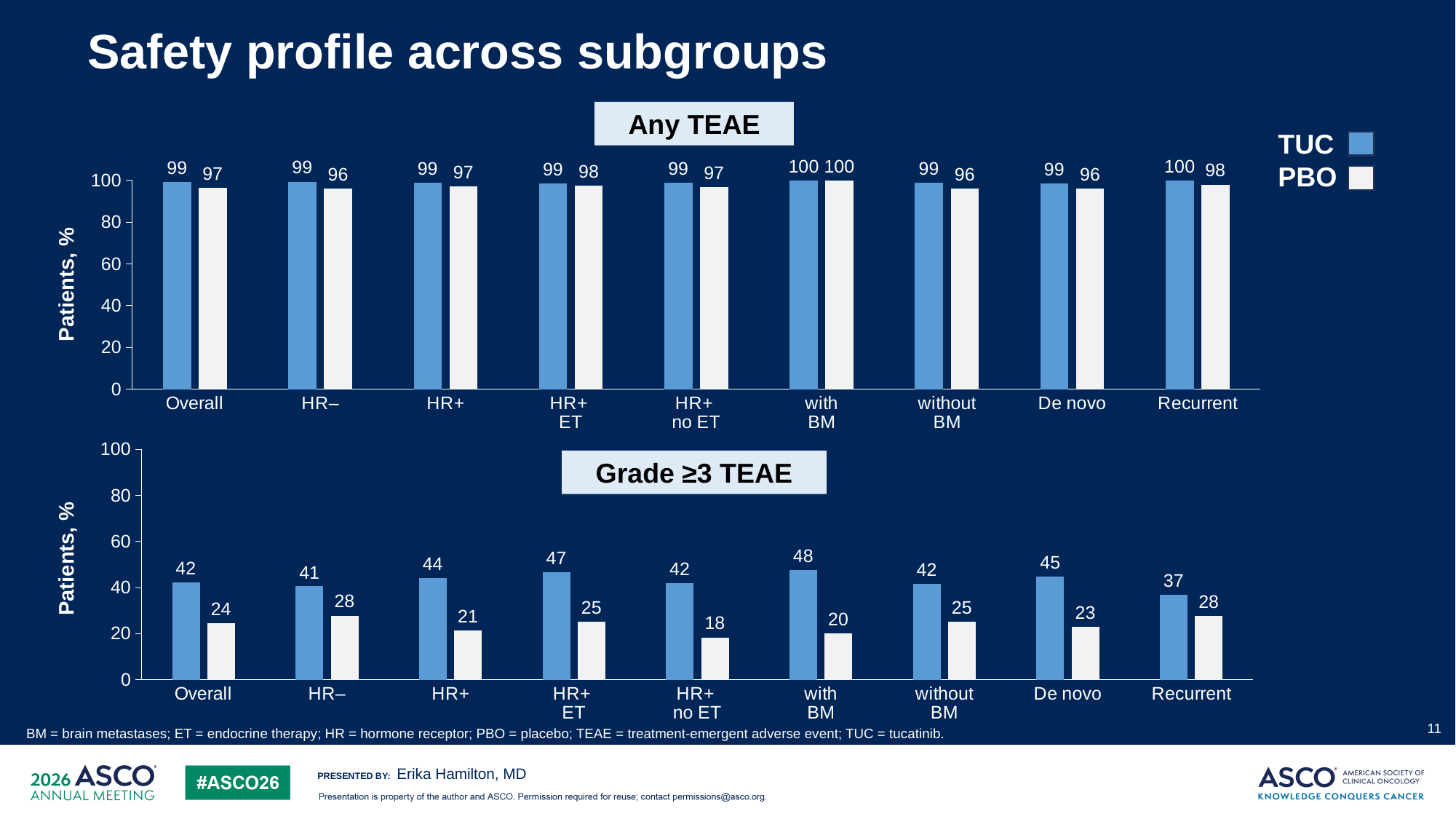
In the Grade ≥3 TEAE chart, is the TUC value for HR+ ET greater or less than 40? greater What kind of chart is the Grade ≥3 TEAE chart? Bar chart In the Any TEAE chart, what is the TUC value for the Overall subgroup? 99 In the Grade ≥3 TEAE chart, what is the PBO value for the HR+ no ET subgroup? 18 How many series does the legend list? 2 In the Grade ≥3 TEAE chart, which subgroup has the lowest PBO value? HR+ no ET How many subgroups are shown on the x axis of the Any TEAE chart? 9 In the Grade ≥3 TEAE chart, what is the difference between the TUC and PBO values for the Overall subgroup? 18 In the Any TEAE chart, what is the PBO value for the HR+ ET subgroup? 98 In the Grade ≥3 TEAE chart, which subgroup has the highest TUC value? with BM In the Grade ≥3 TEAE chart, what is the TUC value for the with BM subgroup? 48 In the Grade ≥3 TEAE chart, which is larger for the Recurrent subgroup, TUC or PBO? TUC